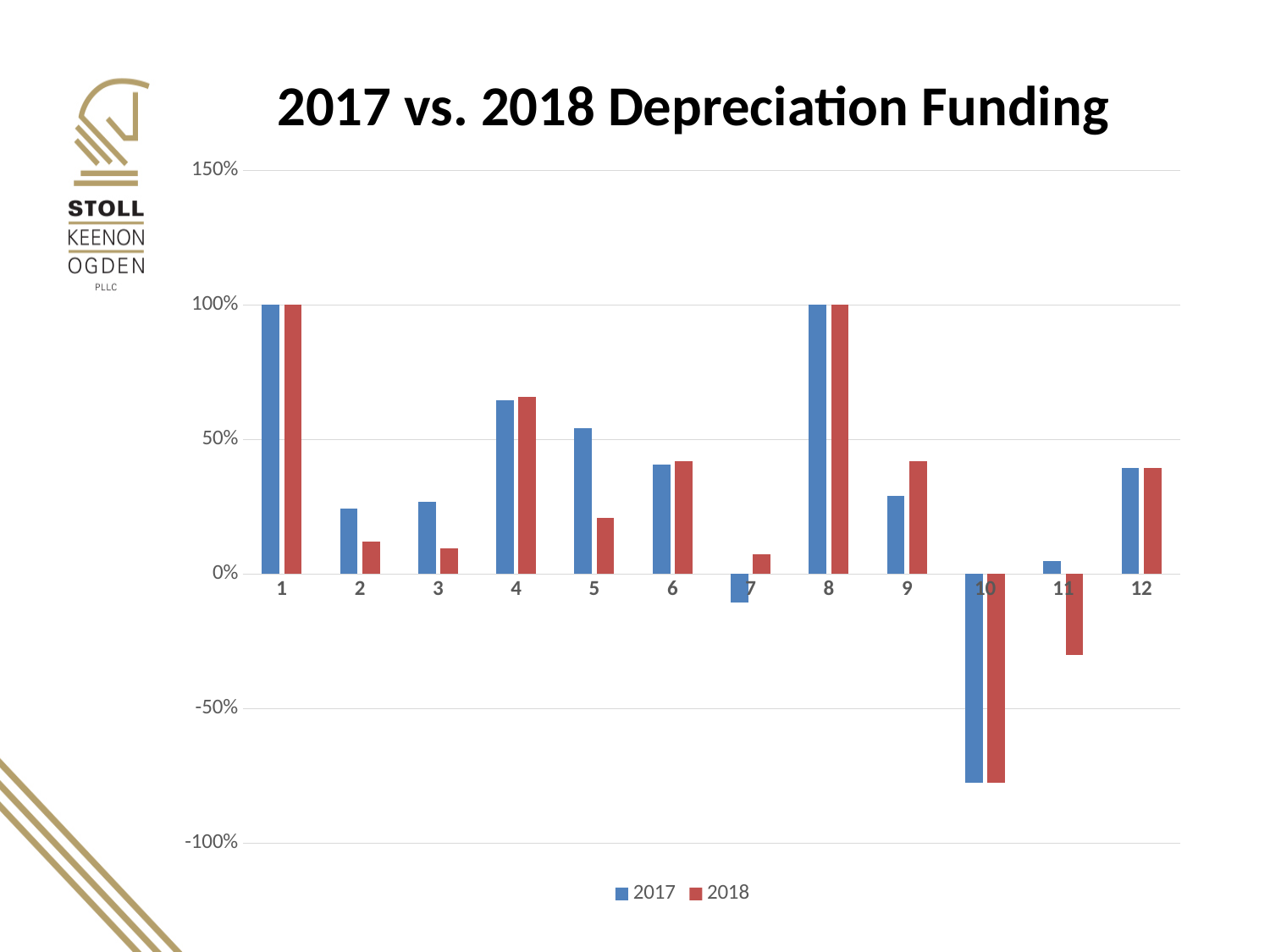
Which category has the lowest 2018 value? 10 For category 9, which series has the larger value, 2017 or 2018? 2018 What type of chart is shown on the slide? Bar chart Is the 2018 value for category 4 greater or less than 50%? greater For category 5, which series has the larger value, 2017 or 2018? 2017 What is the 2018 value for category 8? 100% Is the 2017 value for category 10 greater or less than -50%? less How many series does the legend list? 2 Which category has the lowest 2017 value? 10 How many categories are shown on the x axis? 12 What is the title of the chart? 2017 vs. 2018 Depreciation Funding What is the 2017 value for category 1? 100%